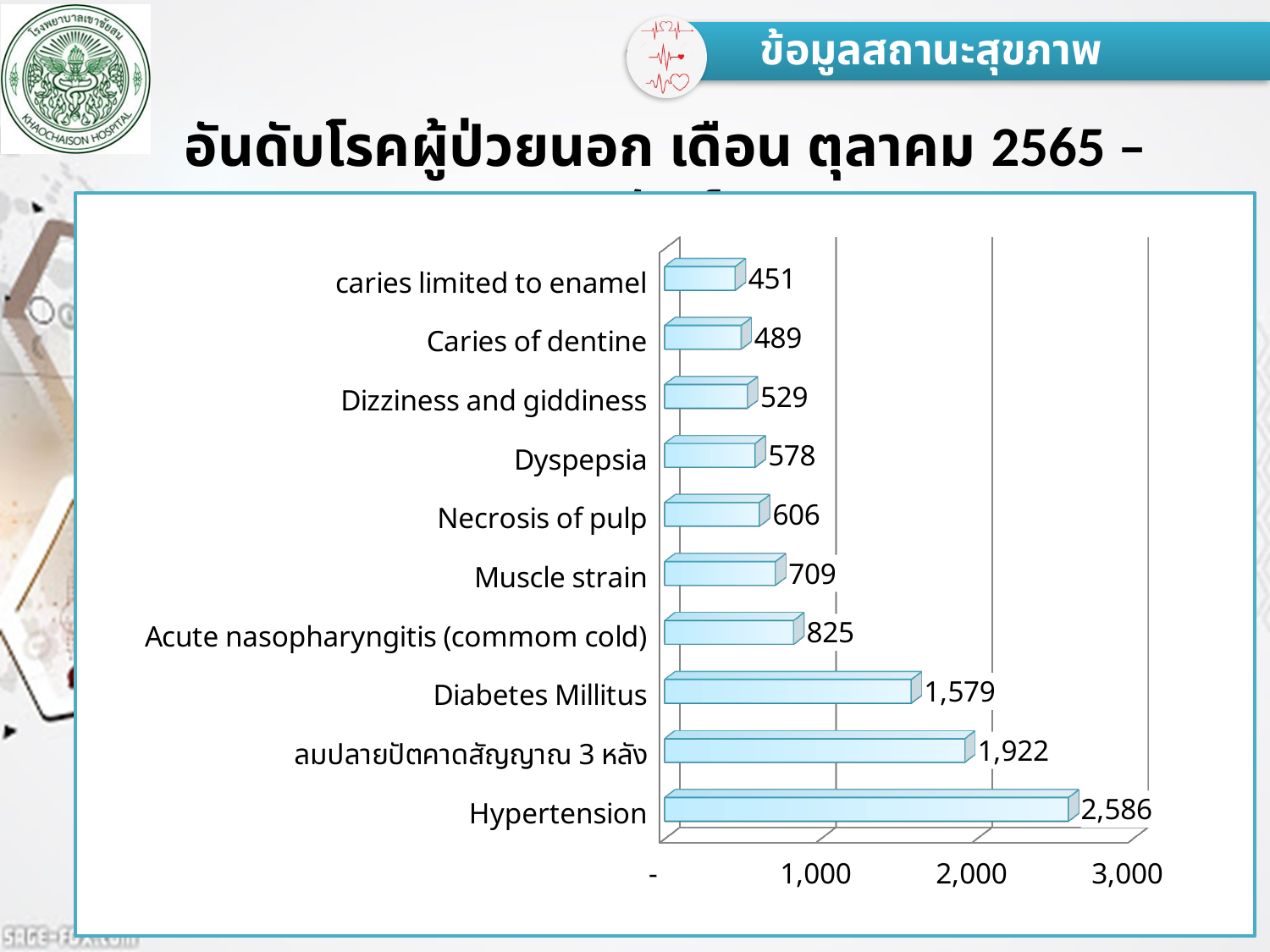
What is the value for Muscle strain? 709 What is the difference between the values for Hypertension and Diabetes Millitus? 1,007 How many categories are shown in the chart? 10 What kind of chart is shown on the slide? bar chart What is the value for Dyspepsia? 578 What is the value for Caries of dentine? 489 What is the value for Diabetes Millitus? 1,579 What is the value for Hypertension? 2,586 Which category has the lowest value? caries limited to enamel Is the value for Acute nasopharyngitis (commom cold) greater or less than 1,000? less Which category has the highest value? Hypertension Which is larger, the value for Necrosis of pulp or the value for Dizziness and giddiness? Necrosis of pulp